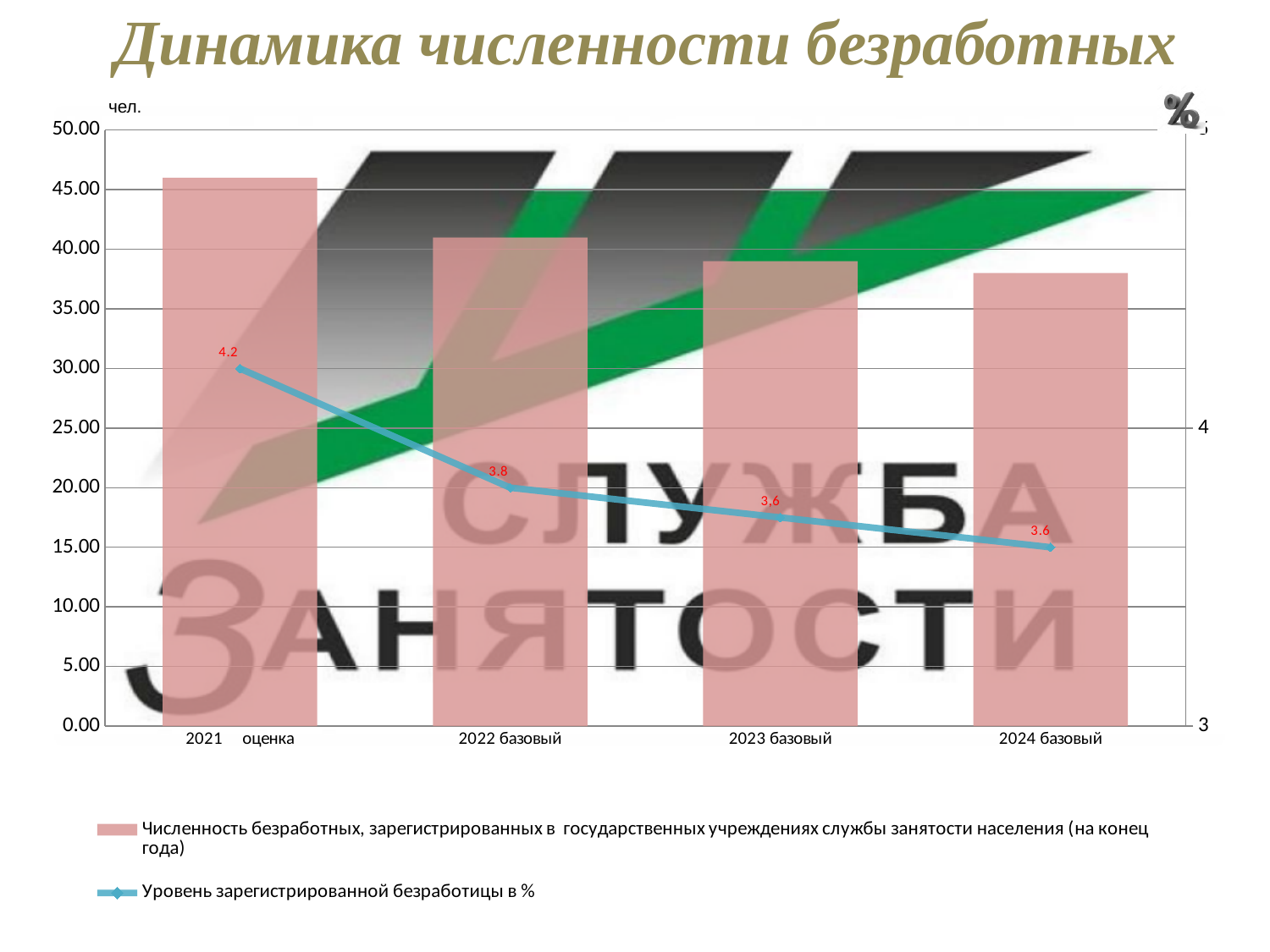
How many series does the legend list? 2 How many categories are shown on the x axis? 4 Which is larger, the unemployment rate for 2022 базовый or for 2023 базовый? 2022 базовый What is the difference between the unemployment rate for 2021 оценка and 2022 базовый? 0.4 What is the value of 'Уровень зарегистрированной безработицы в %' for 2022 базовый? 3.8 Does the unemployment rate line rise or fall from 2021 to 2024? fall Is the bar value for 2024 базовый greater or less than 40.00? less What is the value of 'Уровень зарегистрированной безработицы в %' for 2024 базовый? 3.6 Which category has the tallest bar for the number of registered unemployed? 2021 оценка What is the value of 'Уровень зарегистрированной безработицы в %' for 2021 оценка? 4.2 Is the bar value for 2021 оценка greater or less than 40.00? greater In which category is the registered unemployment rate (line series) highest? 2021 оценка